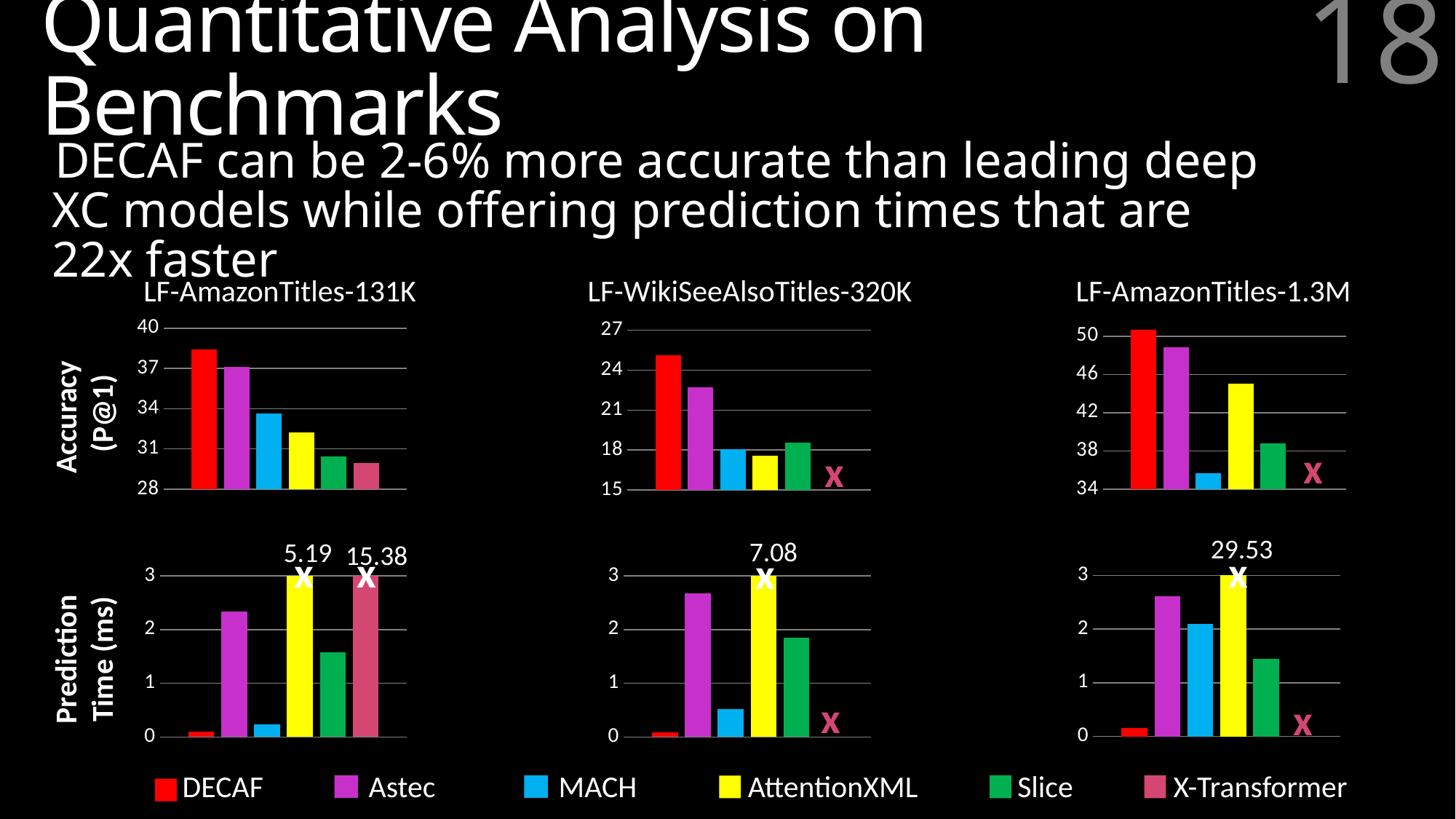
In the Prediction Time chart for LF-AmazonTitles-131K, what is the labelled value for X-Transformer? 15.38 In the Accuracy (P@1) chart for LF-AmazonTitles-131K, which method has the highest accuracy? DECAF What kind of chart is used for the Accuracy (P@1) results on LF-AmazonTitles-131K? bar chart In the Accuracy (P@1) chart for LF-AmazonTitles-1.3M, which method has the lowest accuracy? MACH In the Prediction Time chart for LF-WikiSeeAlsoTitles-320K, what is the labelled value for AttentionXML? 7.08 In the Accuracy (P@1) chart for LF-WikiSeeAlsoTitles-320K, which is higher, DECAF or Astec? DECAF In the Prediction Time chart for LF-AmazonTitles-131K, which method has the lowest prediction time? DECAF In the Prediction Time chart for LF-AmazonTitles-1.3M, what is the labelled value for AttentionXML? 29.53 In the Prediction Time chart for LF-AmazonTitles-131K, what is the difference between the X-Transformer and AttentionXML values? 10.19 In the Accuracy (P@1) chart for LF-AmazonTitles-131K, is the value for DECAF greater or less than 37? greater In the Prediction Time chart for LF-AmazonTitles-131K, what is the labelled value for AttentionXML? 5.19 How many methods does the legend at the bottom of the slide list? 6